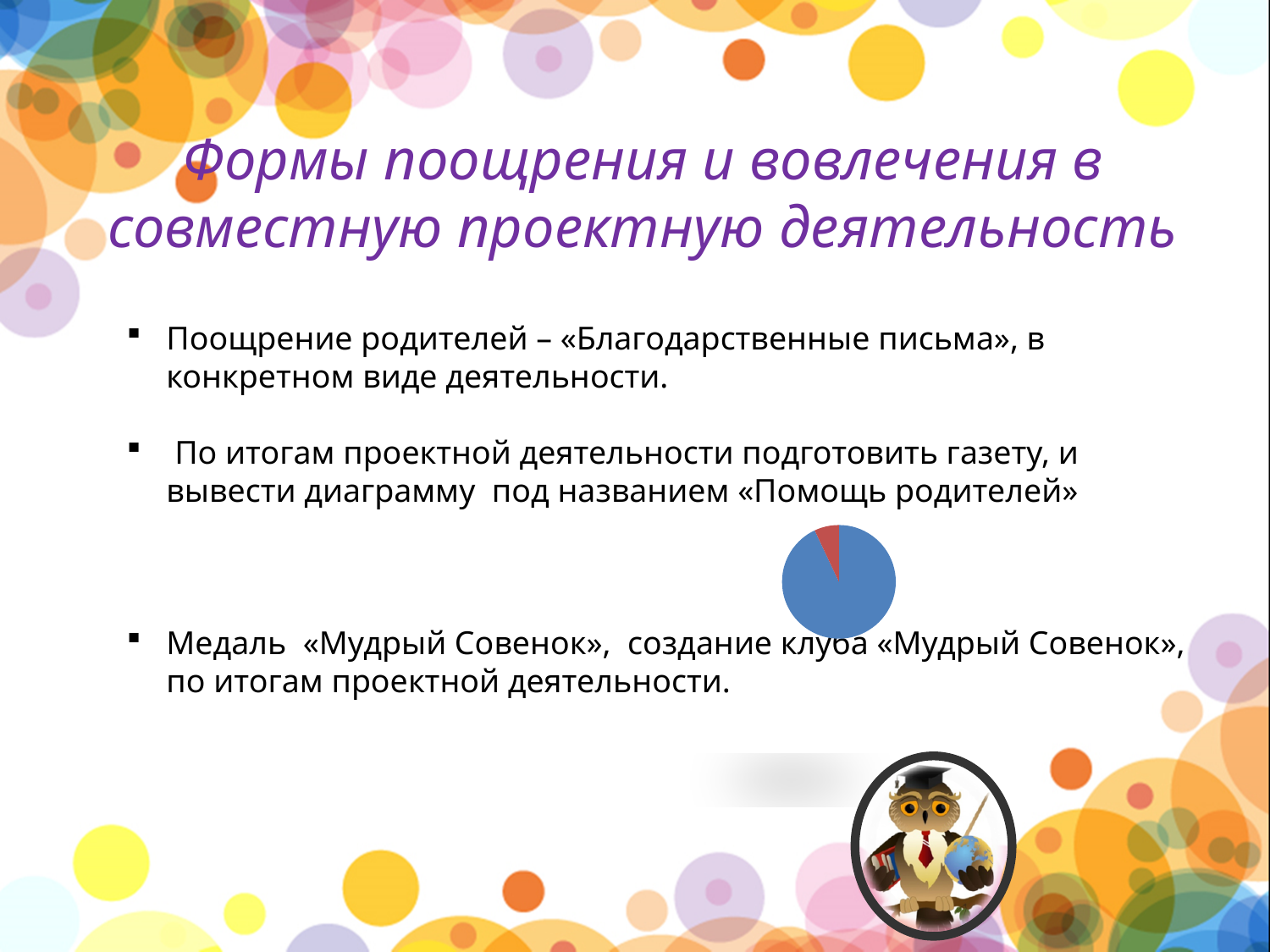
How many slices does the pie chart have? 2 What two colours are used for the slices of the pie chart? blue and red Which slice of the pie chart is larger, the blue one or the red one? the blue one What kind of chart is shown on the slide? pie chart Which colour is the largest slice of the pie chart? blue Does the pie chart display a legend? No Which colour is the smallest slice of the pie chart? red